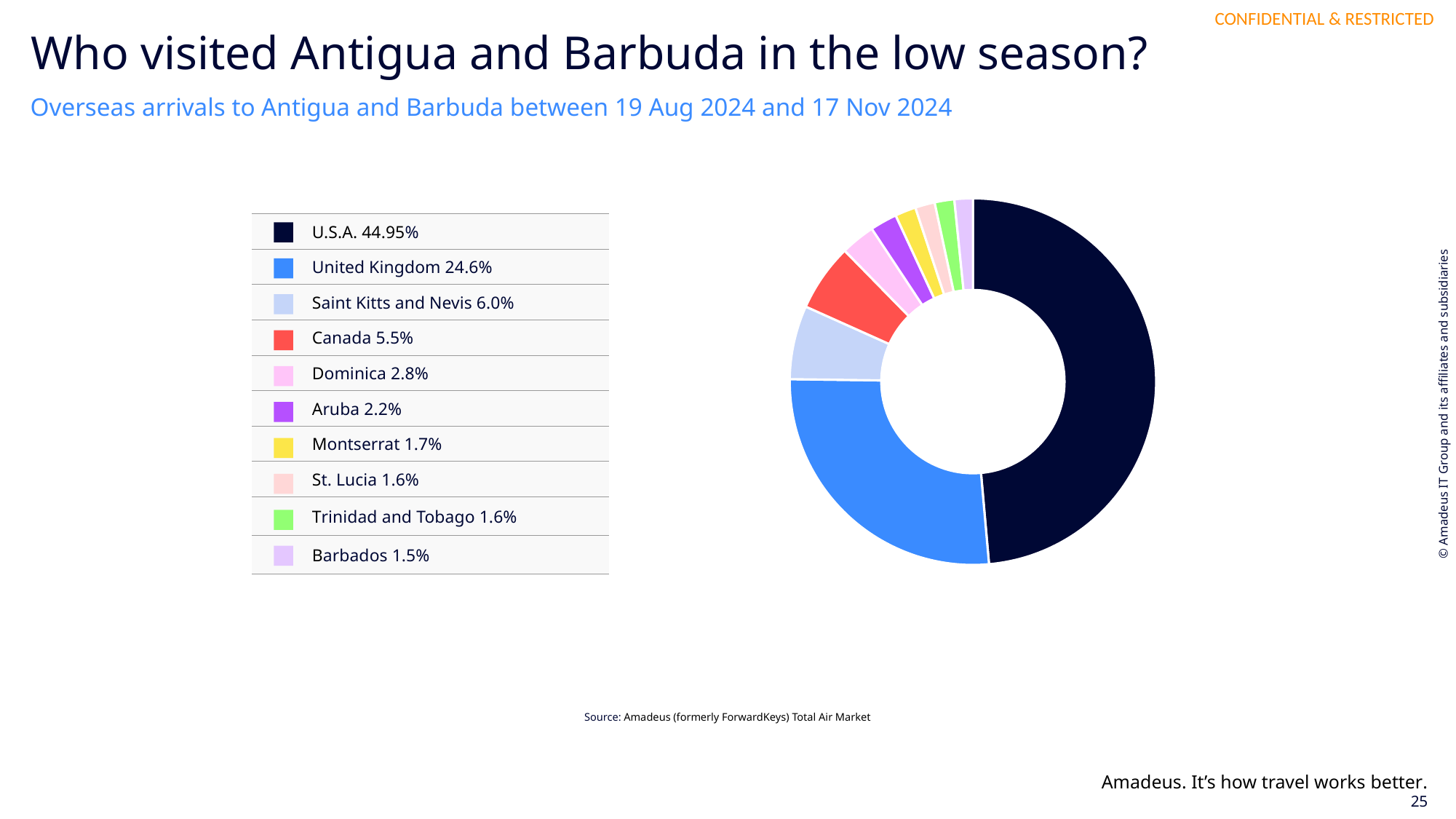
What share of overseas arrivals came from Canada? 5.5% What share of overseas arrivals came from the United Kingdom? 24.6% What colour represents the United Kingdom in the chart? Blue What share of overseas arrivals came from Aruba? 2.2% What kind of chart is shown on the slide? Pie chart (donut) Which origin market has the largest share of arrivals? U.S.A. How many origin markets are listed in the legend? 10 What is the difference in share between the U.S.A. and the United Kingdom? 20.35% Which origin market listed in the legend has the smallest share of arrivals? Barbados What share of overseas arrivals came from the U.S.A.? 44.95% Which has a larger share of arrivals, Dominica or Aruba? Dominica What is the difference in share between Saint Kitts and Nevis and Canada? 0.5%